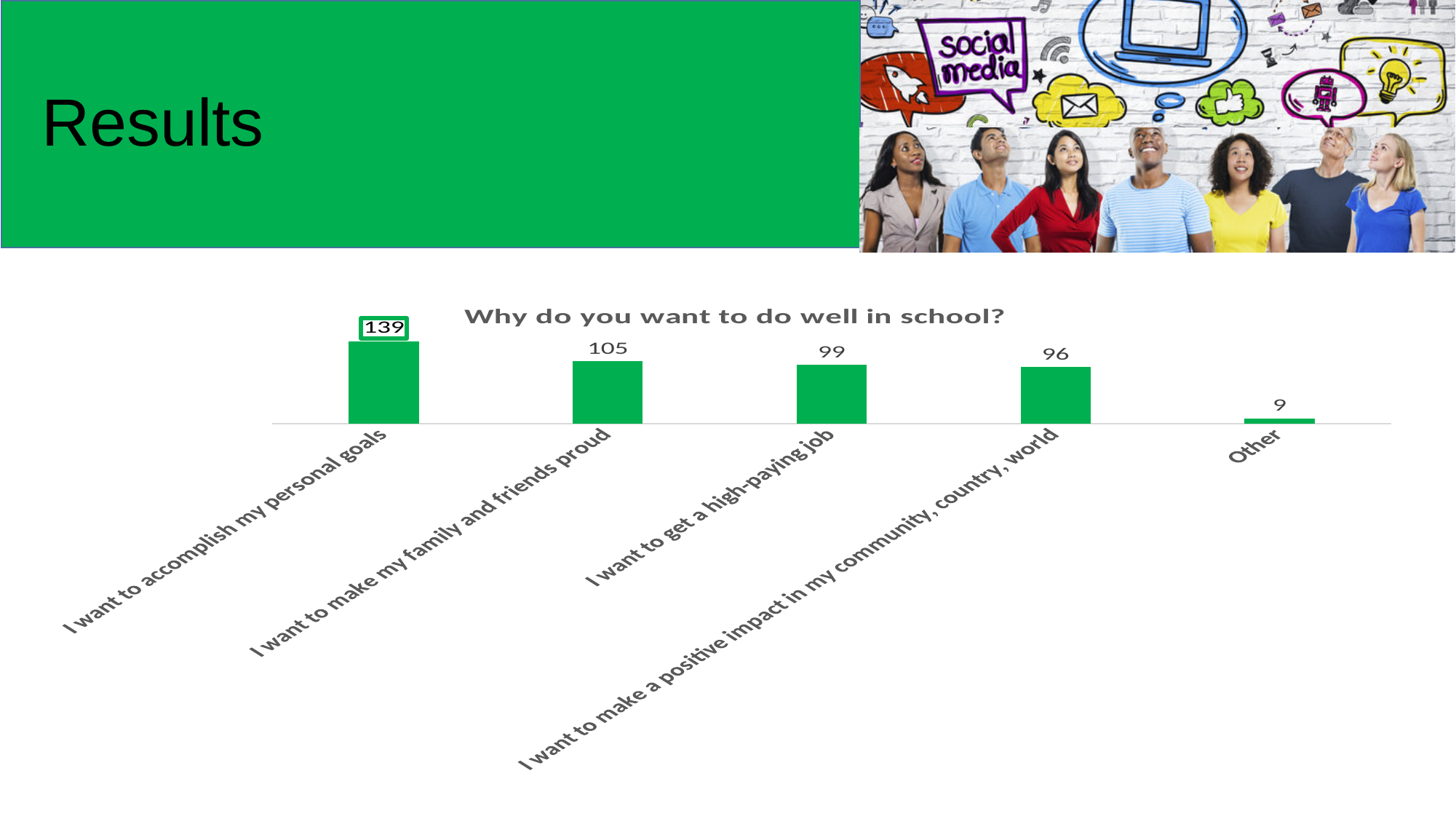
Which category has the highest value? I want to accomplish my personal goals What is the value for "I want to accomplish my personal goals"? 139 What is the value for "I want to make my family and friends proud"? 105 What is the value for "I want to get a high-paying job"? 99 Which category has the lowest value? Other Which is larger: the value for "I want to get a high-paying job" or the value for "Other"? I want to get a high-paying job What is the value for "I want to make a positive impact in my community, country, world"? 96 What is the title of the chart? Why do you want to do well in school? What is the difference between the values for "I want to accomplish my personal goals" and "I want to make my family and friends proud"? 34 What is the value for "Other"? 9 What kind of chart is shown on the slide? Bar chart How many categories are shown in the chart? 5